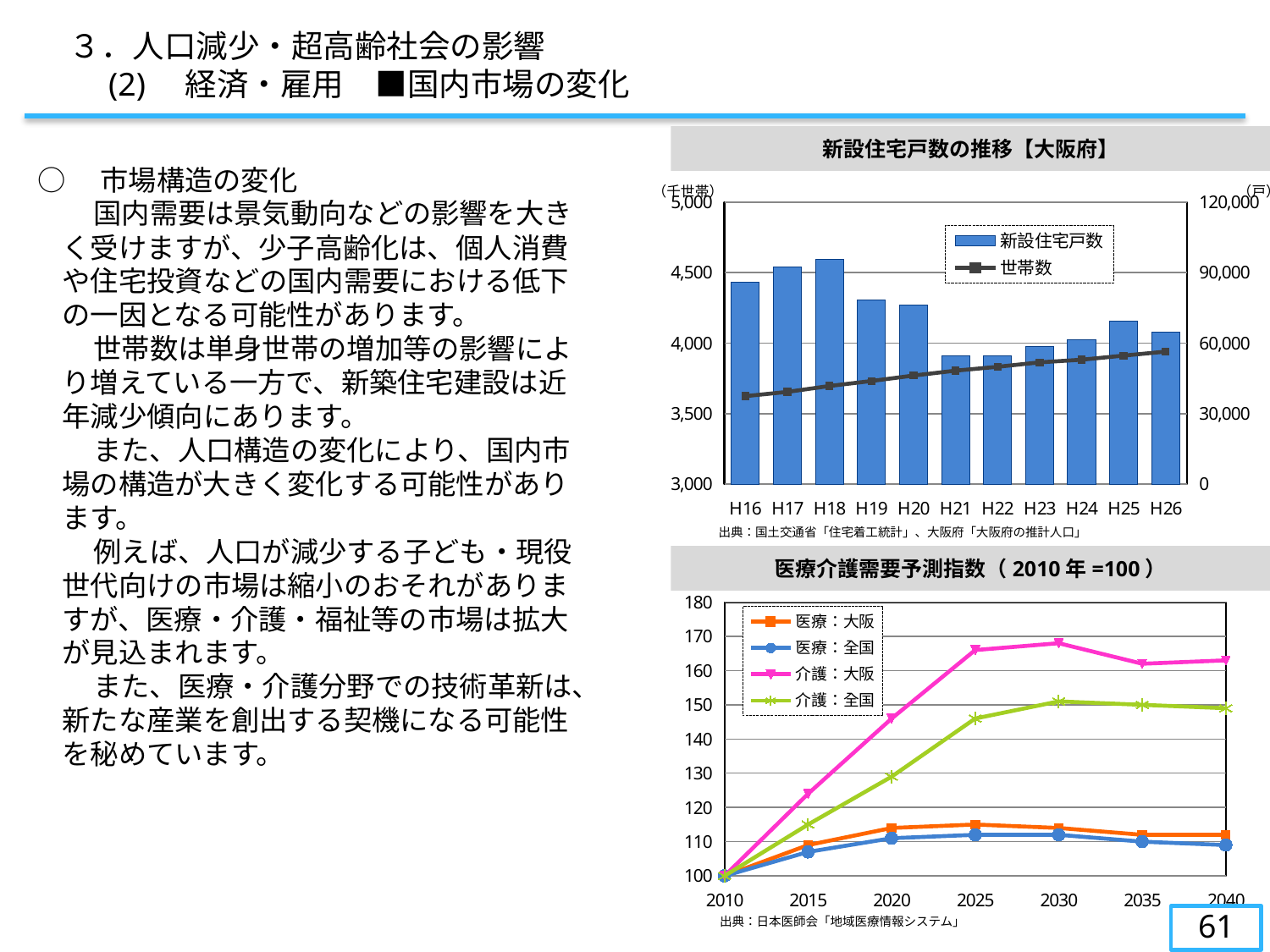
In the 新設住宅戸数の推移【大阪府】 chart, does the 世帯数 line rise or fall from H16 to H26? rise In the 医療介護需要予測指数 chart, how many years are shown on the x axis? 7 In the 新設住宅戸数の推移【大阪府】 chart, how many years are shown on the x axis? 11 In the 医療介護需要予測指数 chart, is the 介護：大阪 value for 2030 greater or less than 160? greater In the 医療介護需要予測指数 chart, which is larger in 2025, 介護：大阪 or 介護：全国? 介護：大阪 In the 新設住宅戸数の推移【大阪府】 chart, is the 新設住宅戸数 value for H16 greater or less than 4,000? greater What kind of chart is the 新設住宅戸数の推移【大阪府】 chart? Bar chart with a line In the 医療介護需要予測指数 chart, how many series does the legend list? 4 In the 新設住宅戸数の推移【大阪府】 chart, which year has the highest 新設住宅戸数 bar? H18 In the 医療介護需要予測指数 chart, which series has the highest value in 2040? 介護：大阪 In the 新設住宅戸数の推移【大阪府】 chart, how many series does the legend list? 2